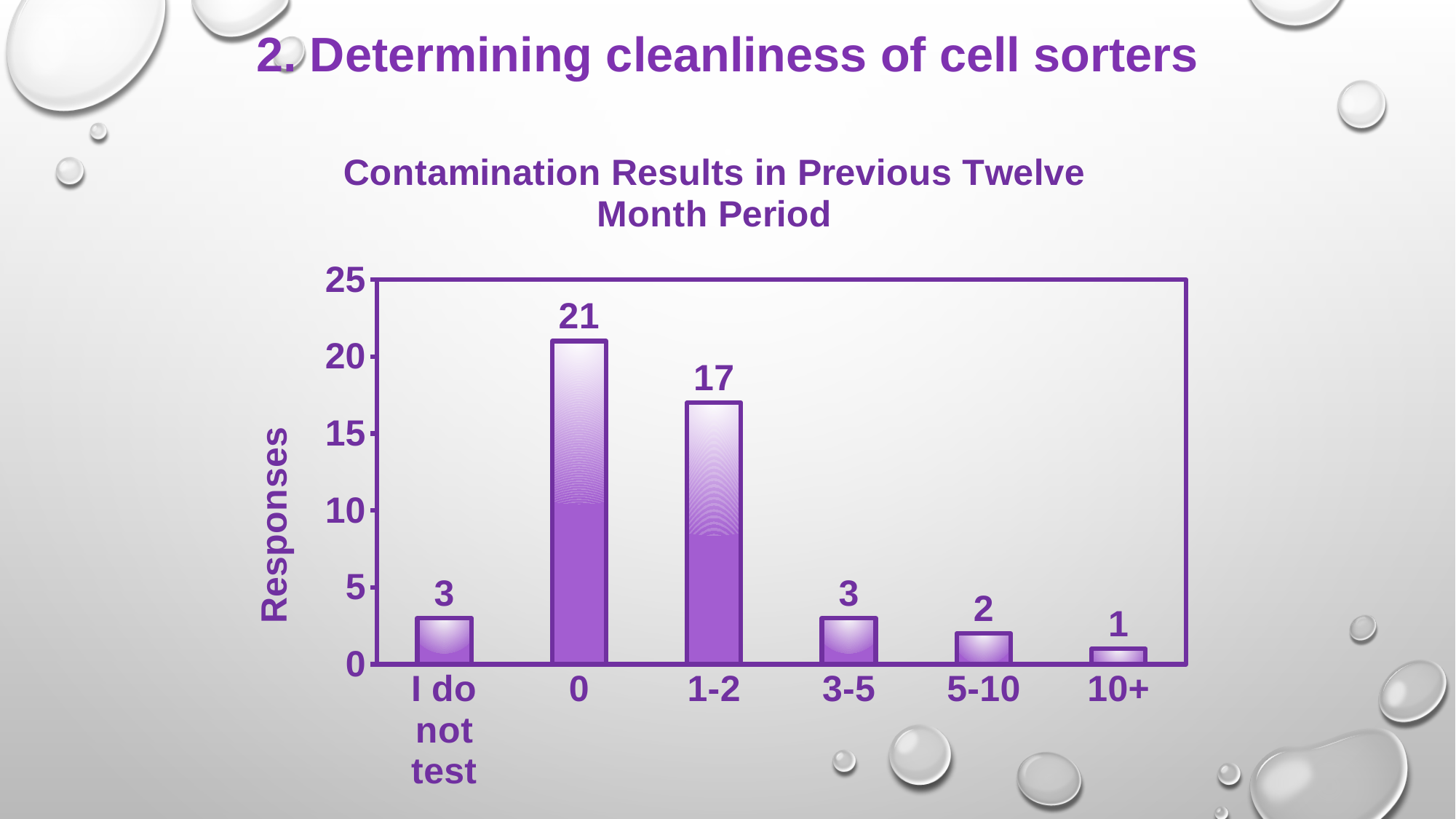
What is the title of the chart? Contamination Results in Previous Twelve Month Period How many categories are shown on the x axis? 6 Which has more responses, "3-5" or "5-10"? 3-5 What is the number of responses for "I do not test"? 3 What is the number of responses for the "0" category? 21 Is the value for "1-2" greater or less than 15? greater What is the number of responses for the "10+" category? 1 Which category has the lowest number of responses? 10+ What is the number of responses for the "1-2" category? 17 Which category has the highest number of responses? 0 What is the difference in responses between the "0" and "1-2" categories? 4 What kind of chart is shown on the slide? Bar chart